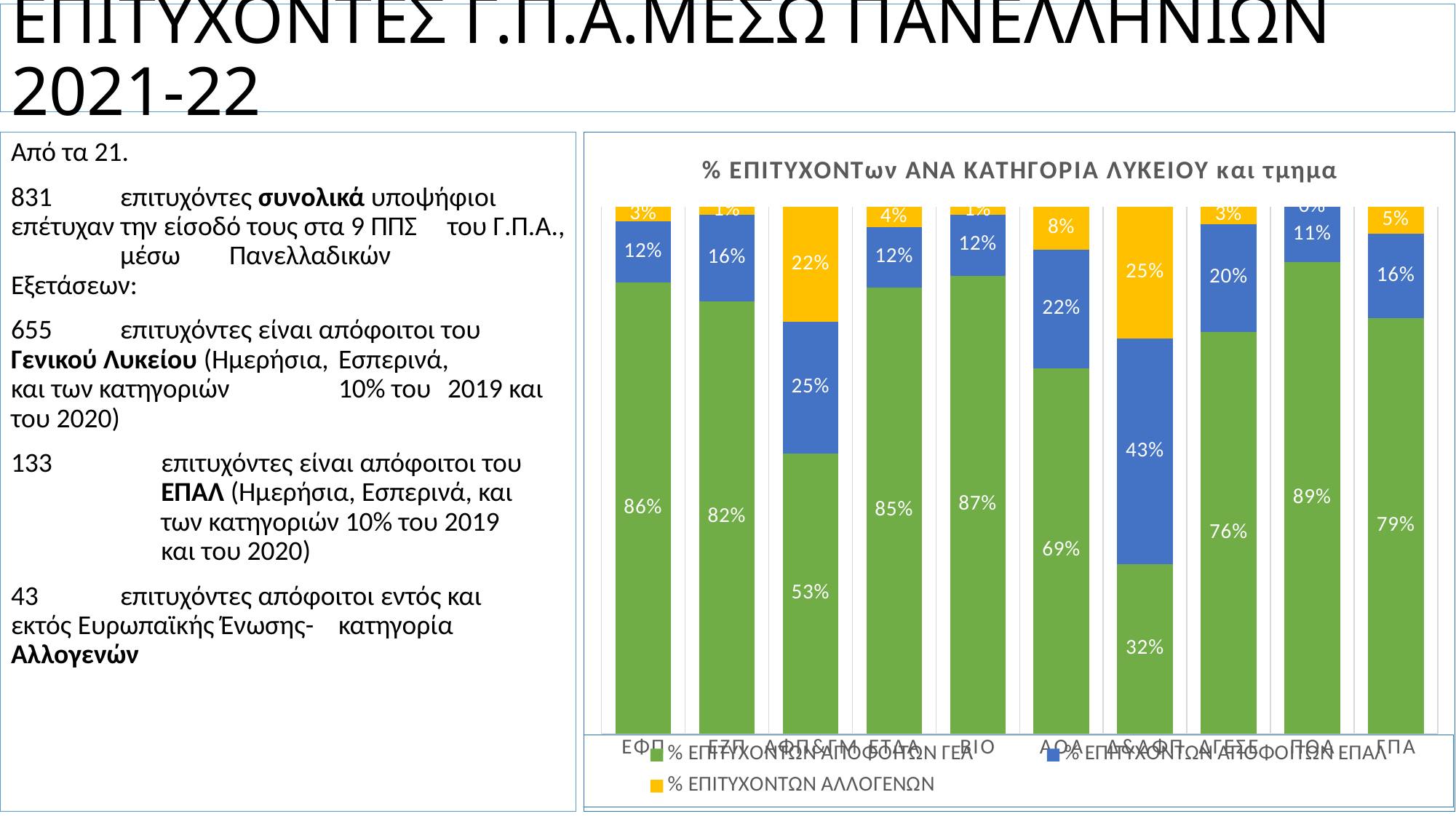
Which is larger: the ΕΠΑΛ graduate percentage for ΑΟΑ or for ΓΠΑ? ΑΟΑ What is the value of the ΑΛΛΟΓΕΝΩΝ series (yellow) for ΑΟΑ? 8% What kind of chart is shown on the slide? Stacked bar chart Which department has the highest percentage of ΓΕΛ graduates (green series)? ΠΟΑ Which colour represents the % ΕΠΙΤΥΧΟΝΤΩΝ ΑΛΛΟΓΕΝΩΝ series? Yellow How many series does the legend list? 3 What is the value of the ΓΕΛ graduates series (green) for ΑΦΠ&ΓΜ? 53% How many departments (categories) are shown on the x axis? 10 Which department has the lowest percentage of ΓΕΛ graduates (green series)? Δ&ΔΦΠ